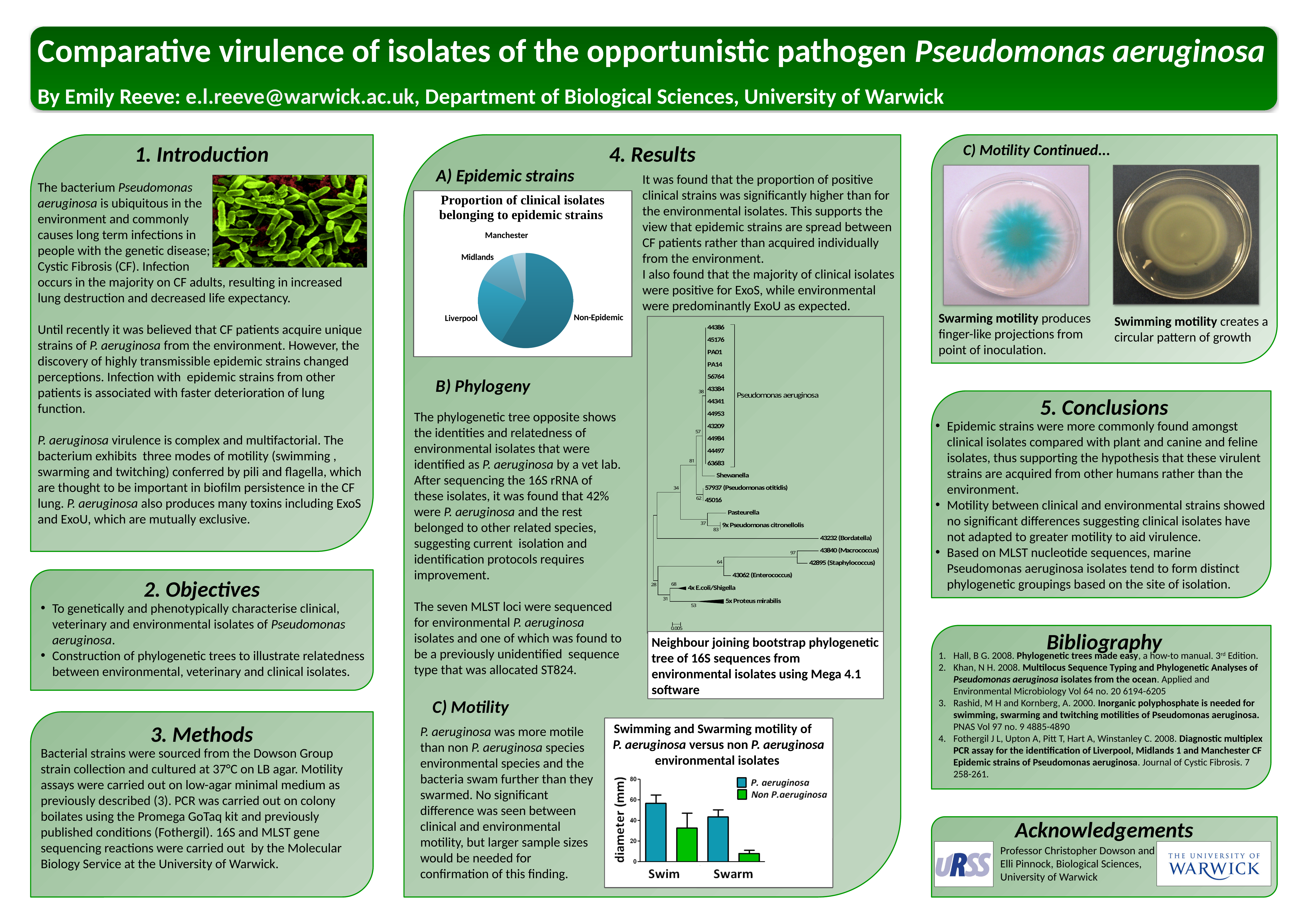
In the 'Swimming and Swarming motility' chart, is the P. aeruginosa value for Swim greater or less than 40? greater In the 'Swimming and Swarming motility' chart, is the Non P. aeruginosa value for Swarm greater or less than 20? less In the 'Proportion of clinical isolates belonging to epidemic strains' pie chart, which slice is larger, Liverpool or Midlands? Liverpool In the 'Swimming and Swarming motility' chart, which series has the larger value for Swarm, P. aeruginosa or Non P. aeruginosa? P. aeruginosa How many categories are shown on the x axis of the 'Swimming and Swarming motility' chart? 2 In the 'Proportion of clinical isolates belonging to epidemic strains' pie chart, which slice is the smallest? Manchester In the 'Proportion of clinical isolates belonging to epidemic strains' pie chart, which slice is the largest? Non-Epidemic How many series does the legend of the 'Swimming and Swarming motility' chart list? 2 What kind of chart is the 'Swimming and Swarming motility' chart? bar chart How many slices does the 'Proportion of clinical isolates belonging to epidemic strains' pie chart have? 4 What is the y-axis label of the 'Swimming and Swarming motility' chart? diameter (mm) What kind of chart is the 'Proportion of clinical isolates belonging to epidemic strains' chart? pie chart